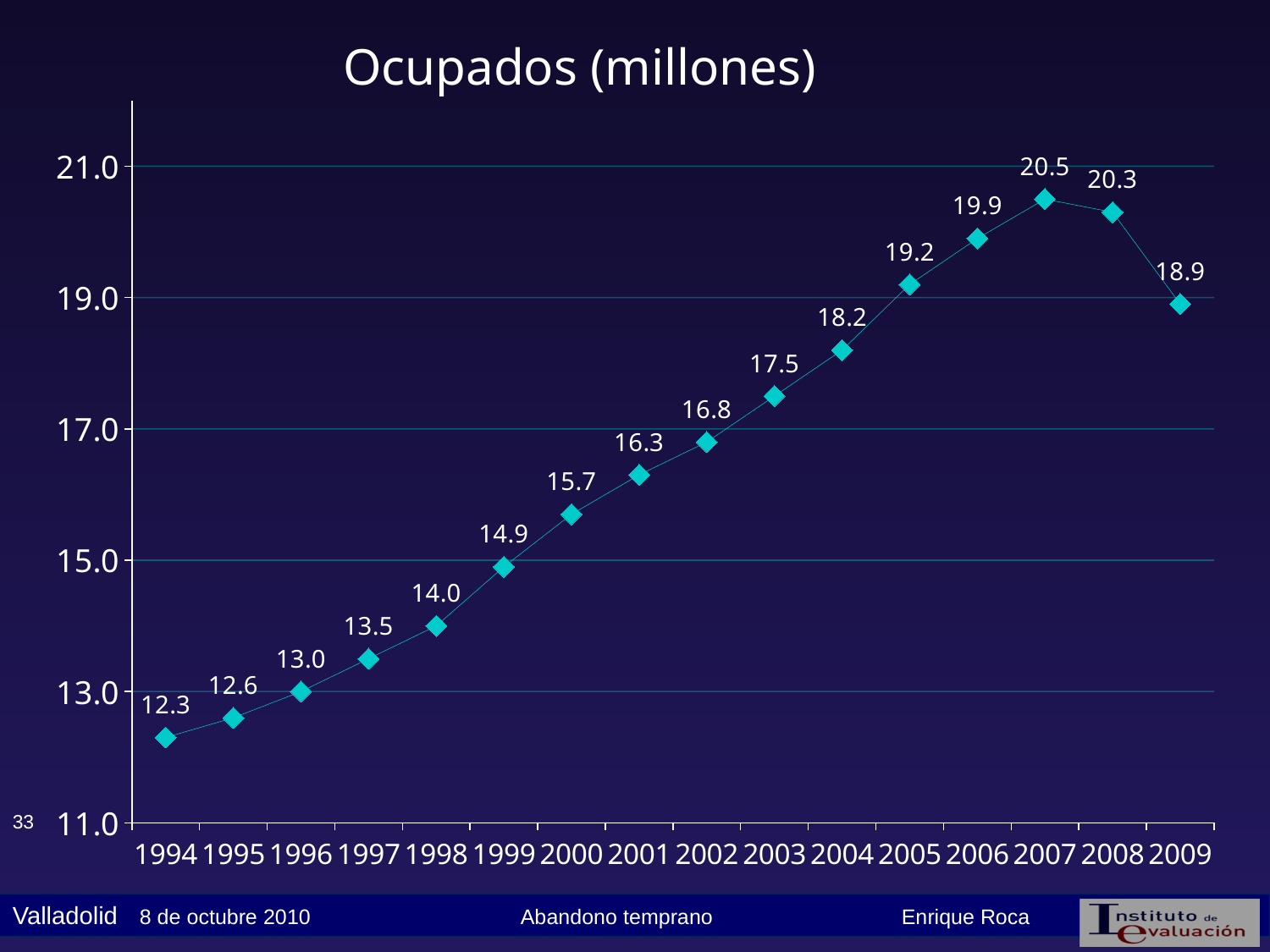
What is the title of the chart? Ocupados (millones) Which year has the highest value? 2007 Which year has the lowest value? 1994 What is the value for 2002? 16.8 What kind of chart is shown? line chart Which is larger, the value for 2008 or the value for 2009? 2008 What is the difference between the values for 2004 and 1994? 5.9 Is the value for 2003 greater or less than 17.0? greater How many years are plotted on the chart? 16 What is the difference between the values for 2007 and 2009? 1.6 What is the value for 2007? 20.5 What is the value for 1994? 12.3